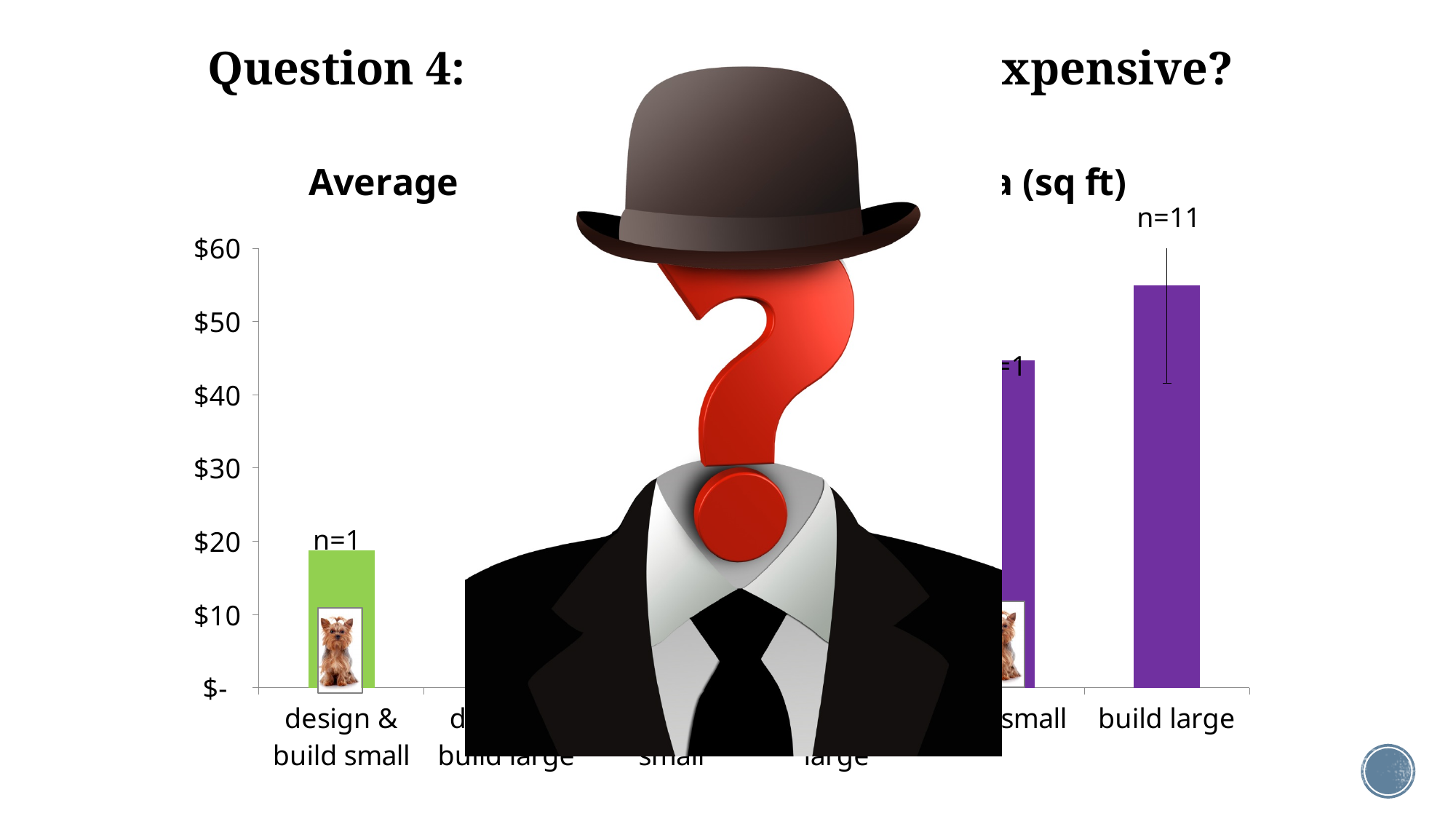
Is the value for 'design & build small' greater or less than $10? greater What colour is the 'design & build small' bar? green Is the value for 'build large' greater or less than $50? greater Is the value for 'build large' greater or less than $60? less Which has the larger value, 'build large' or 'design & build small'? build large What kind of chart is shown on the slide? bar chart What colour is the 'build large' bar? purple What sample-size label is printed above the 'build large' bar? n=11 What is the highest value shown on the y axis? $60 What sample-size label is printed above the 'design & build small' bar? n=1